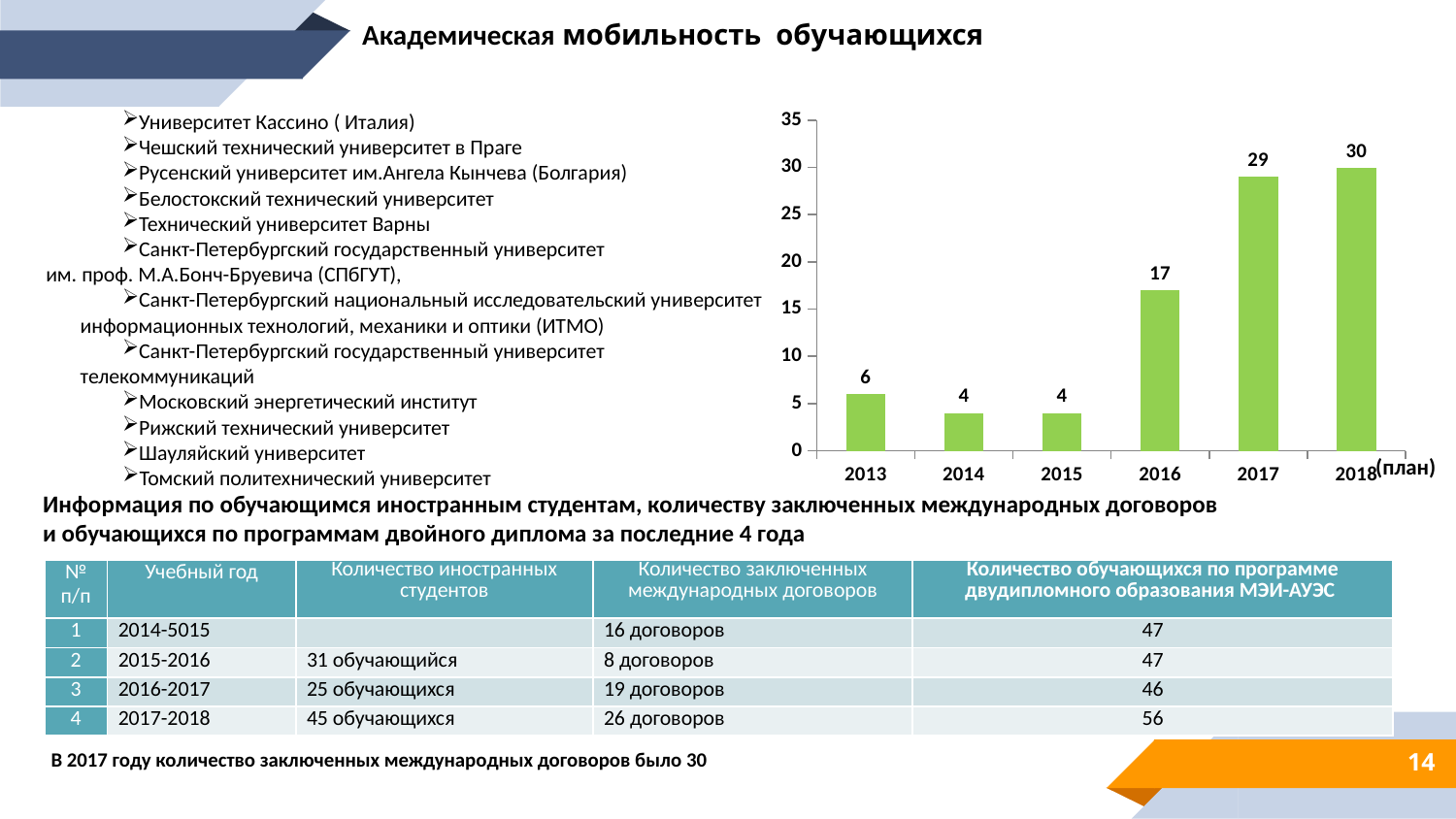
Which year has the highest value in the bar chart? 2018 (план) What is the value for 2013 in the bar chart? 6 Is the value for 2017 in the bar chart greater or less than 25? greater What is the difference between the values for 2013 and 2014 in the bar chart? 2 How many years (categories) are shown on the x axis of the bar chart? 6 Which is larger in the bar chart, the value for 2016 or the value for 2013? 2016 What is the value for 2018 (план) in the bar chart? 30 What kind of chart is shown on the slide? bar chart What is the value for 2016 in the bar chart? 17 What is the difference between the values for 2017 and 2016 in the bar chart? 12 Do the values in the bar chart generally rise or fall from 2015 to 2018 (план)? rise What is the value for 2017 in the bar chart? 29